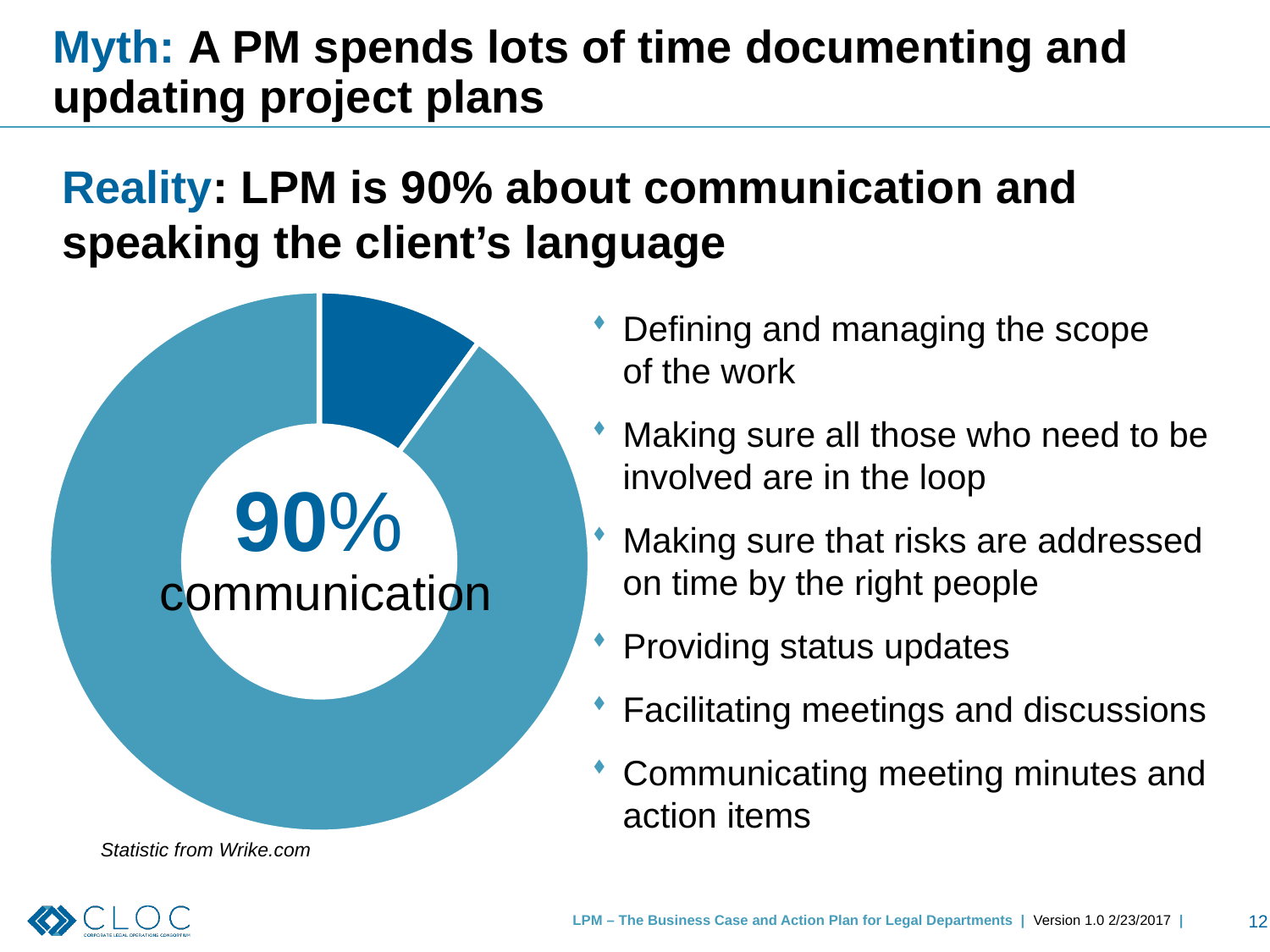
Which slice of the chart is the smallest? the dark blue slice How many slices does the donut chart have? 2 What colour is the communication slice of the chart? light blue What percentage does the chart show for communication? 90% Is the value for communication greater or less than 50%? greater What kind of chart is shown on the left of the slide? pie chart (donut) Which slice of the chart is the largest? communication Which is larger: the communication slice or the dark blue slice? communication What share of the chart does the dark blue slice represent? 10% According to the note under the chart, where is the statistic from? Wrike.com